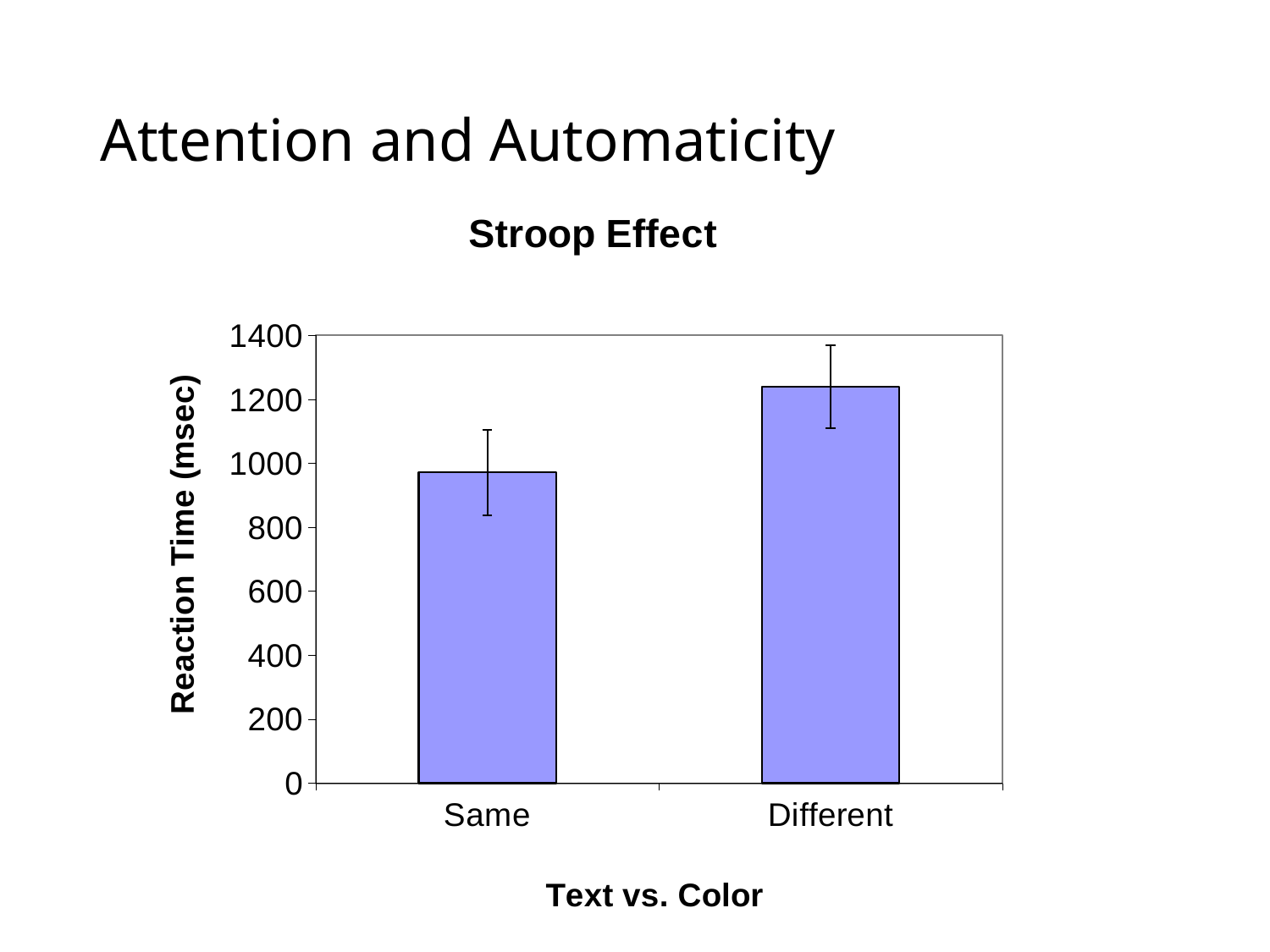
What kind of chart is shown on the slide? bar chart Which category has the highest reaction time? Different What is the title of the chart? Stroop Effect Is the value for Same greater or less than 1000? less Is the value for Different greater or less than 1400? less Is the value for Same greater or less than 800? greater Which has a larger reaction time, Same or Different? Different What is the label of the y axis? Reaction Time (msec) How many categories are shown on the x axis? 2 Do the values rise or fall from Same to Different along the x axis? rise Which category has the lowest reaction time? Same